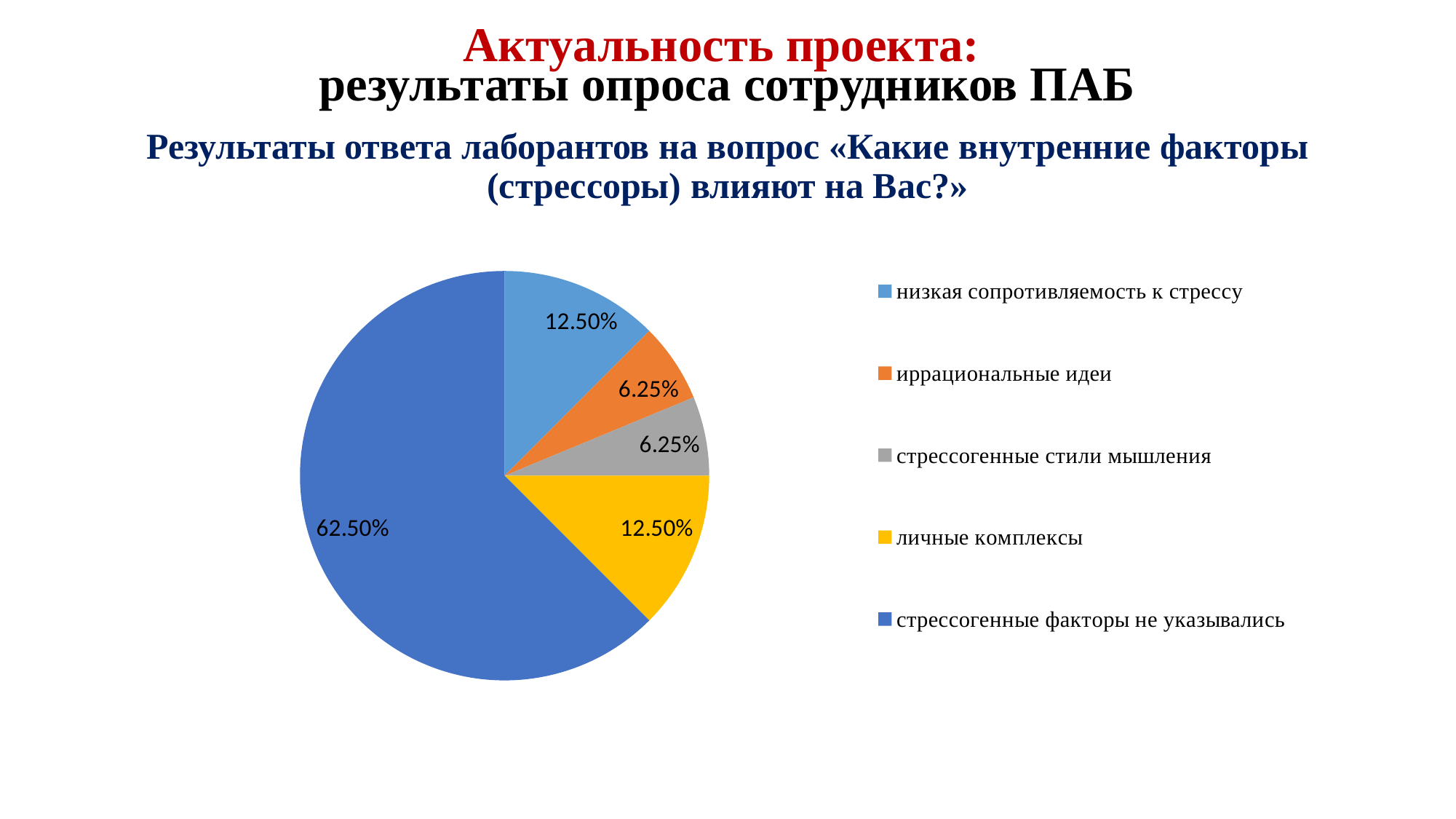
Which is larger: the share for "низкая сопротивляемость к стрессу" or the share for "стрессогенные стили мышления"? низкая сопротивляемость к стрессу How many slices does the pie chart have? 5 How many entries does the legend list? 5 What colour is the slice for "личные комплексы"? yellow What share of the pie is labelled "иррациональные идеи"? 6.25% What is the difference between the share for "низкая сопротивляемость к стрессу" and the share for "иррациональные идеи"? 6.25% What is the difference between the share for "стрессогенные факторы не указывались" and the share for "личные комплексы"? 50.00% Which category has the largest slice of the pie? стрессогенные факторы не указывались What share of the pie is labelled "личные комплексы"? 12.50% What share of the pie is labelled "низкая сопротивляемость к стрессу"? 12.50% What kind of chart is shown on the slide? pie chart What share of the pie is labelled "стрессогенные факторы не указывались"? 62.50%